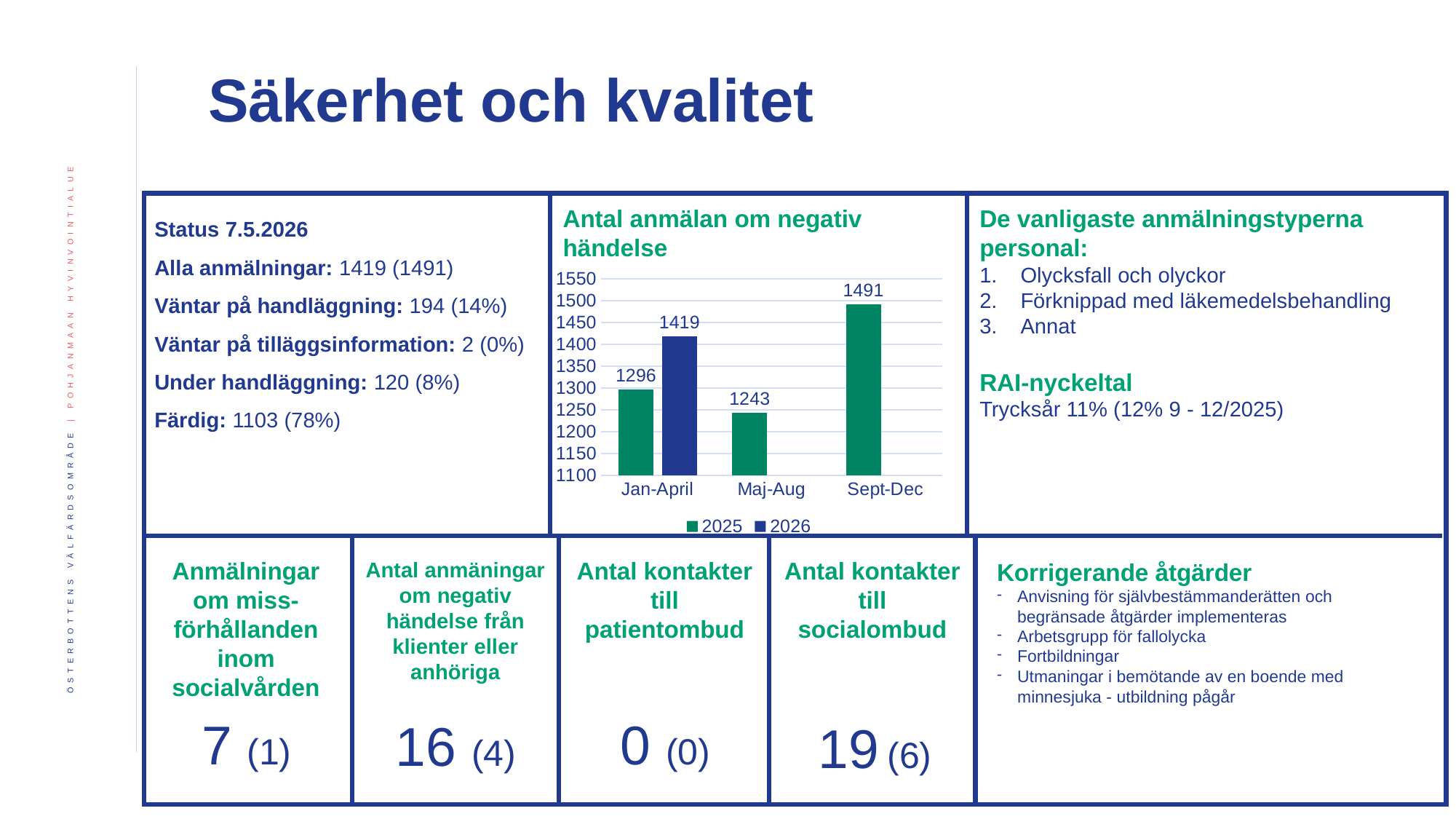
How many series does the legend of the chart 'Antal anmälan om negativ händelse' list? 2 Which period has the highest 2025 value in the chart 'Antal anmälan om negativ händelse'? Sept-Dec What type of chart is 'Antal anmälan om negativ händelse'? Bar chart How many periods are shown on the x axis of the chart 'Antal anmälan om negativ händelse'? 3 What is the value for 2025 in Jan-April in the chart 'Antal anmälan om negativ händelse'? 1296 What is the value for 2025 in Maj-Aug in the chart 'Antal anmälan om negativ händelse'? 1243 What is the value for 2025 in Sept-Dec in the chart 'Antal anmälan om negativ händelse'? 1491 In the chart 'Antal anmälan om negativ händelse', which is larger: the 2025 value for Jan-April or the 2025 value for Maj-Aug? Jan-April What is the value for 2026 in Jan-April in the chart 'Antal anmälan om negativ händelse'? 1419 In the chart 'Antal anmälan om negativ händelse', what is the difference between the 2025 values for Sept-Dec and Maj-Aug? 248 In the chart 'Antal anmälan om negativ händelse', what is the difference between the 2026 and 2025 values for Jan-April? 123 Which period has the lowest 2025 value in the chart 'Antal anmälan om negativ händelse'? Maj-Aug